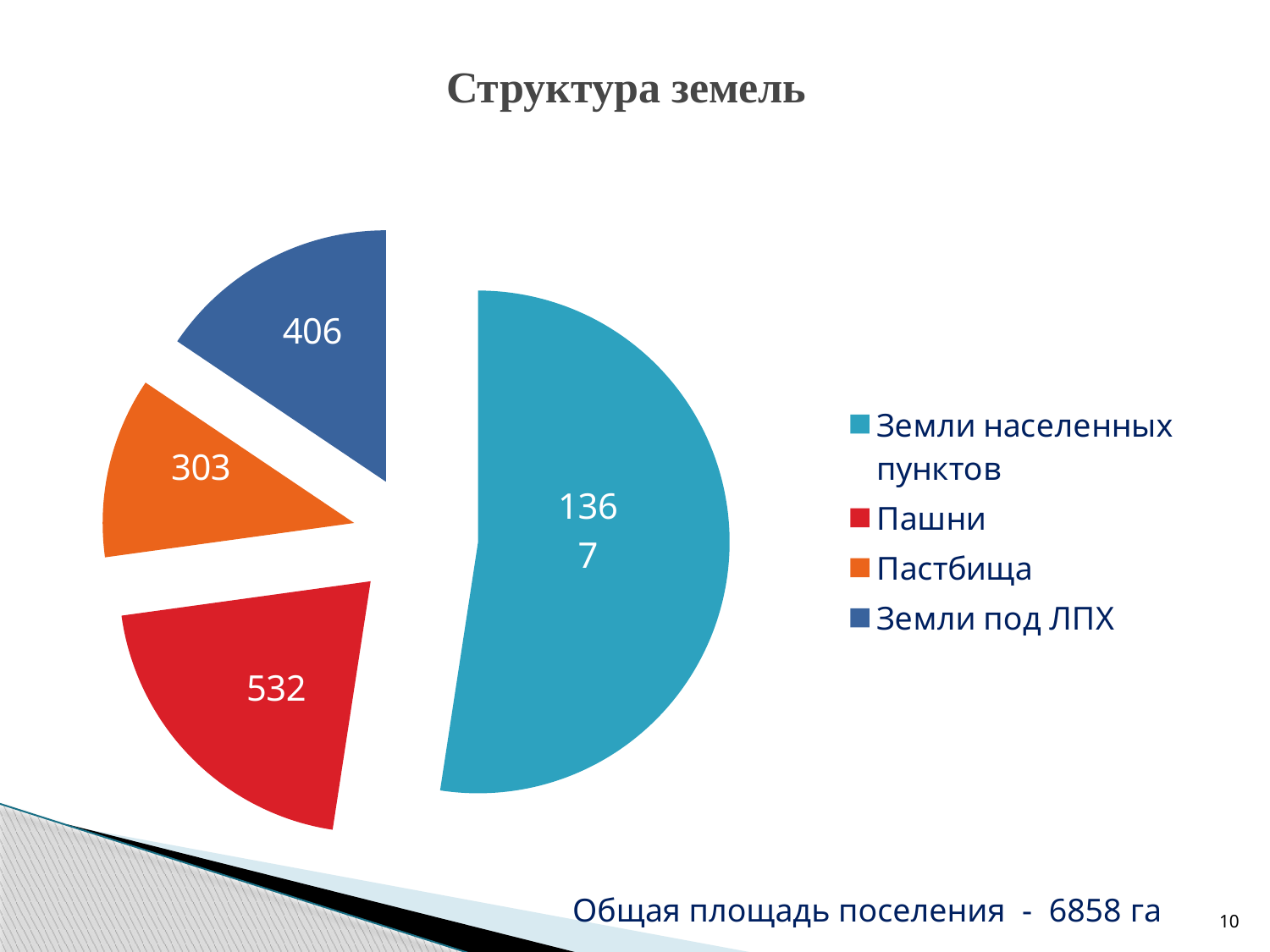
What is the difference between the values for Пашни and Пастбища? 229 What is the sum of all four slice values in the pie chart? 2608 Which is larger, the value for Пашни or the value for Земли под ЛПХ? Пашни What kind of chart is shown on the slide? pie chart What is the value for Пастбища? 303 Which category has the smallest slice? Пастбища What is the value for Пашни? 532 What is the value for Земли под ЛПХ? 406 Which category has the largest slice? Земли населенных пунктов What is the value for Земли населенных пунктов? 1367 What is the title of the chart? Структура земель How many slices does the pie chart have? 4